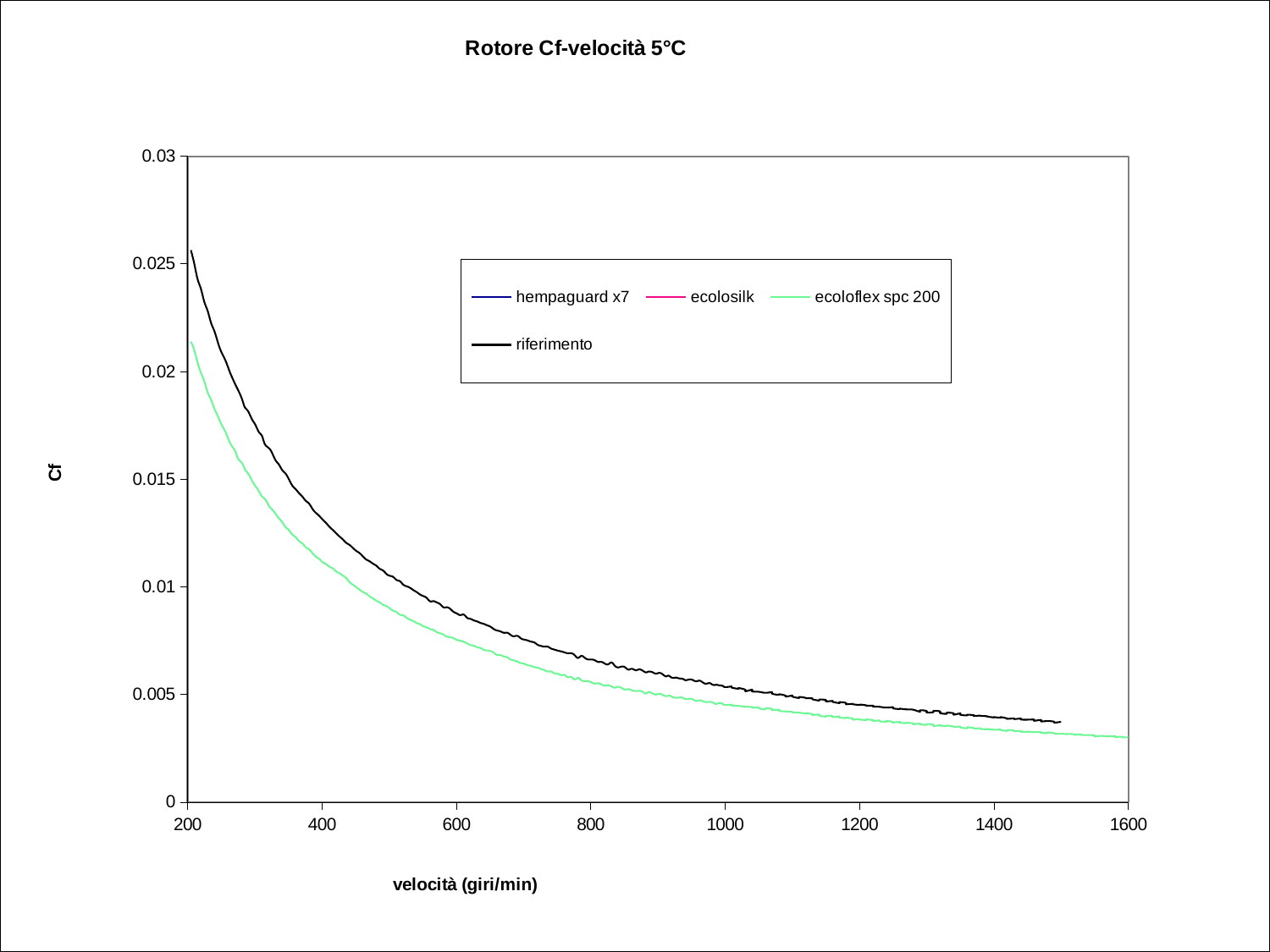
Is the value of ecoloflex spc 200 at 600 giri/min greater or less than 0.01? less Which of the two visible lines has the higher Cf values across the velocità range? riferimento Is the value of ecoloflex spc 200 at 1400 giri/min greater or less than 0.005? less How many series does the legend list? 4 What is the title of the chart? Rotore Cf-velocità 5°C Is the value of riferimento at 200 giri/min greater or less than 0.02? greater What kind of chart is shown on the slide? line chart What is the label of the x axis? velocità (giri/min) At 600 giri/min, which is larger: riferimento or ecoloflex spc 200? riferimento Do the Cf values rise or fall as velocità increases? fall